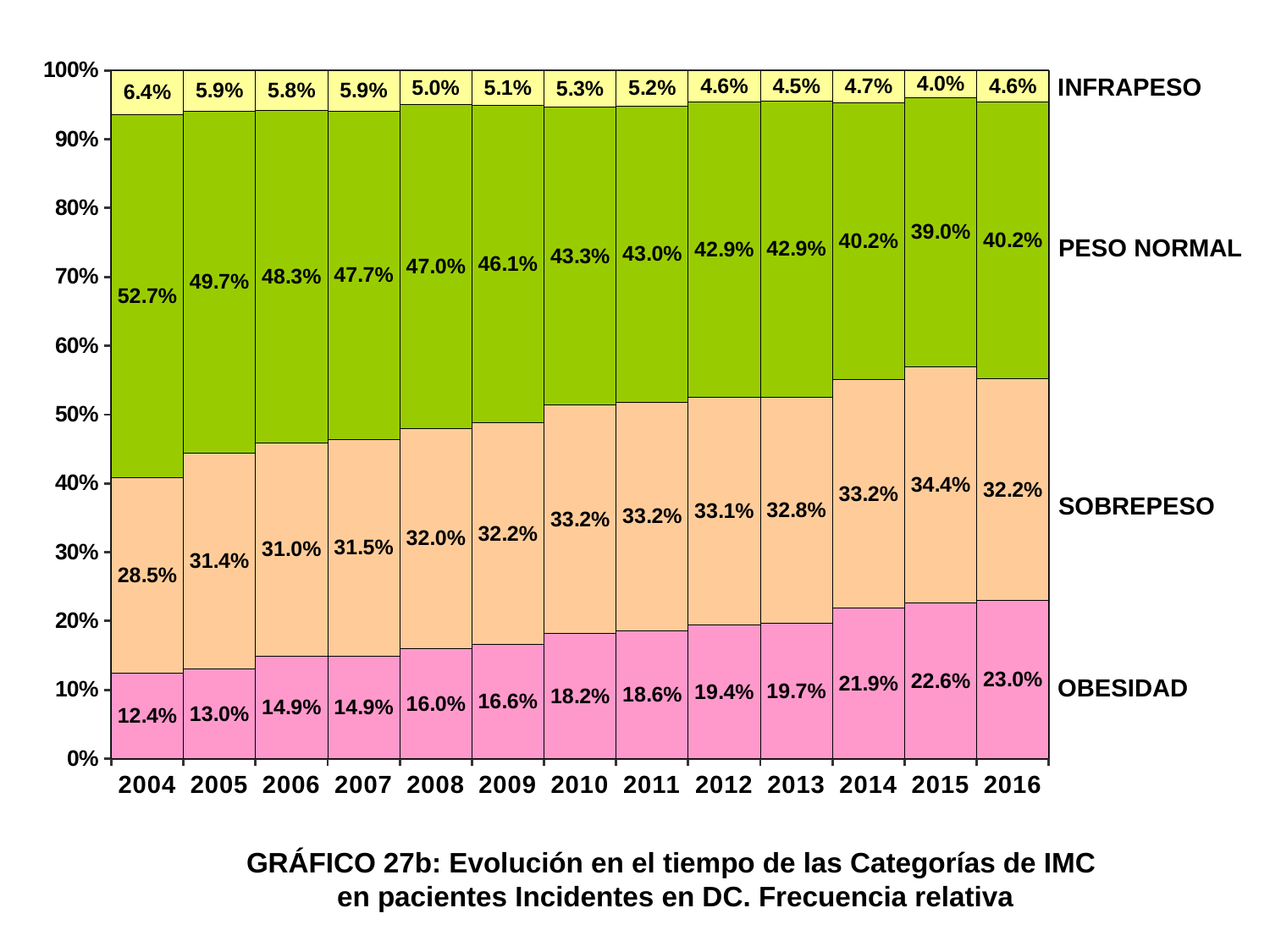
Does the OBESIDAD share rise or fall from 2004 to 2016? Rises What is the value for OBESIDAD in 2004? 12.4% Which year has the larger SOBREPESO share, 2015 or 2016? 2015 How many BMI categories (series) are stacked in each bar? 4 What kind of chart is shown on the slide? Stacked bar chart By how many percentage points did PESO NORMAL fall from 2004 to 2016? 12.5% What is the value for INFRAPESO in 2010? 5.3% How many years are shown on the x axis? 13 In which year is the OBESIDAD share highest? 2016 In which year is the INFRAPESO share lowest? 2015 What is the value for PESO NORMAL in 2016? 40.2% What is the value for SOBREPESO in 2015? 34.4%